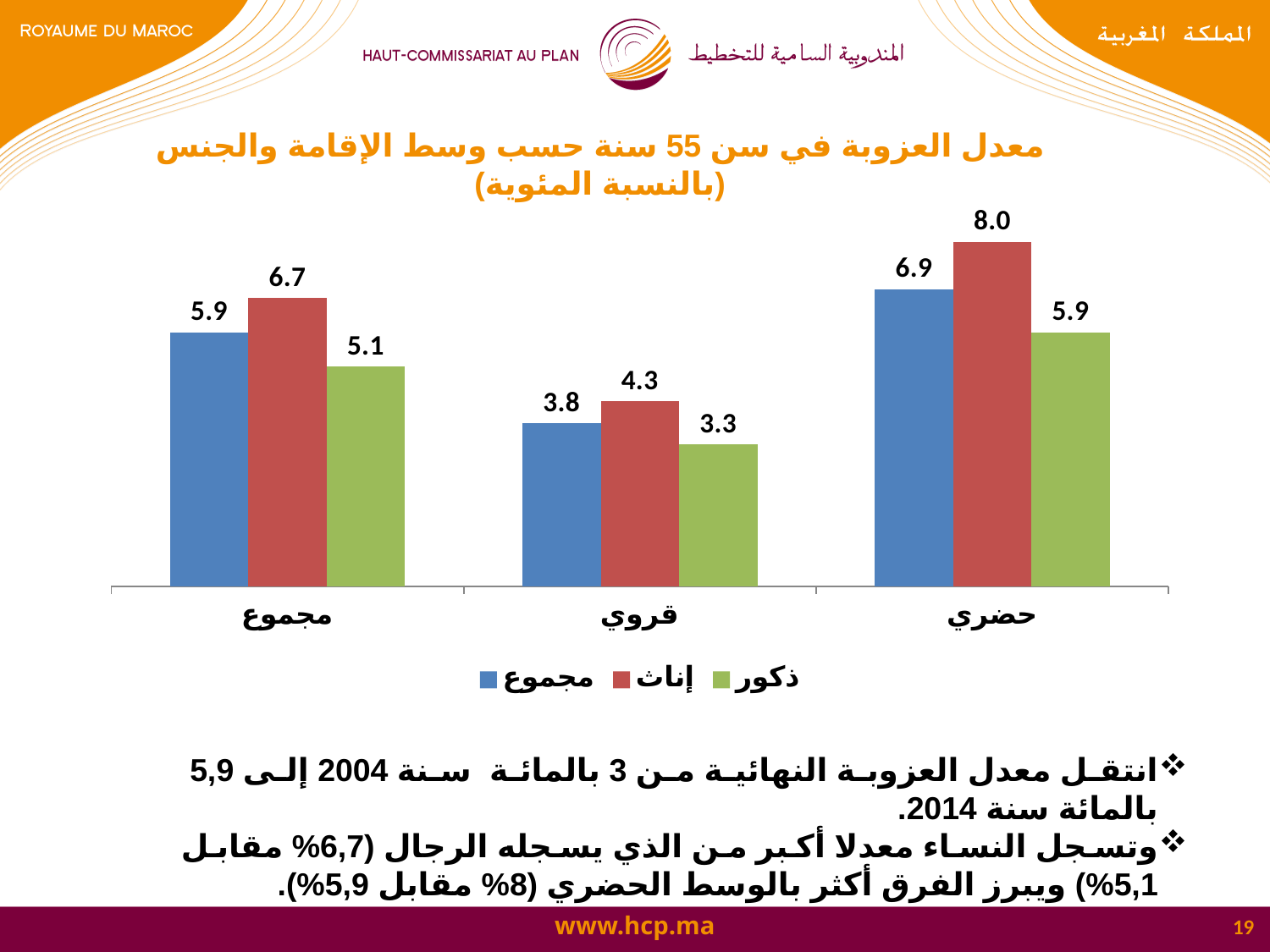
Which colour represents the إناث series in the chart? red Which category has the highest value for the إناث series? حضري How many categories are shown on the x axis? 3 What kind of chart is shown on the slide? bar chart What is the value for إناث in the قروي category? 4.3 How many series does the legend list? 3 What is the value for ذكور in the قروي category? 3.3 Which is larger in the مجموع category: the value for إناث or the value for ذكور? إناث What is the difference between the إناث and ذكور values in the حضري category? 2.1 Which category has the lowest value for the ذكور series? قروي What is the value for إناث in the حضري category? 8.0 What is the value for the مجموع series in the مجموع category? 5.9